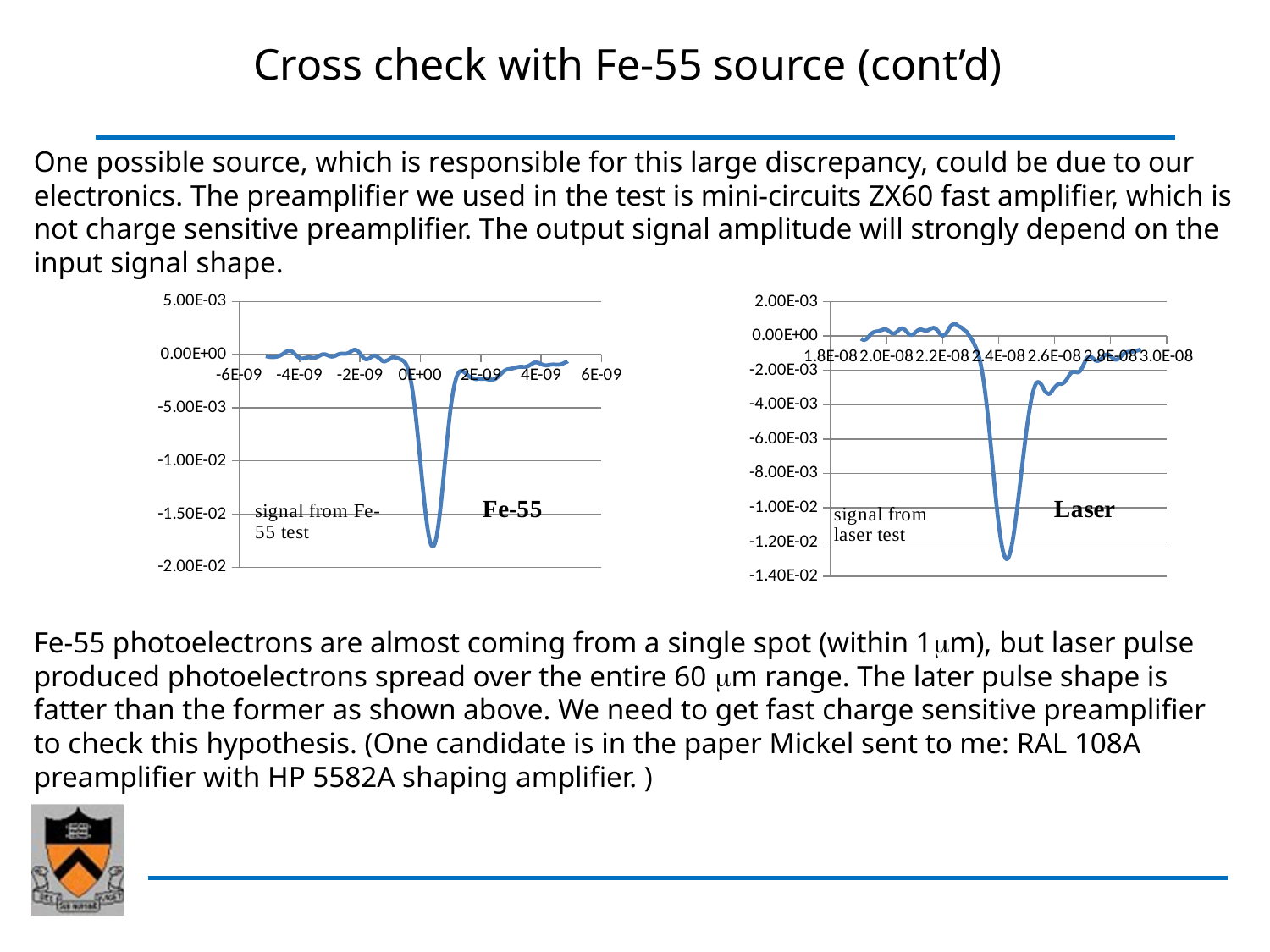
What is the highest tick label on the y axis of the Fe-55 chart? 5.00E-03 How many series does the legend of the Fe-55 chart list? 1 Which chart's signal reaches a lower minimum value, the Fe-55 chart or the Laser chart? Fe-55 chart What is the legend entry of the Laser chart? signal from laser test In the Fe-55 chart, is the minimum value of the signal greater or less than -1.50E-02? less In the Laser chart, is the minimum value of the signal greater or less than -1.20E-02? less In the Fe-55 chart, is the minimum value of the signal greater or less than -2.00E-02? greater How many series does the legend of the Laser chart list? 1 What kind of chart is the Fe-55 chart on the left? line chart What kind of chart is the Laser chart on the right? line chart